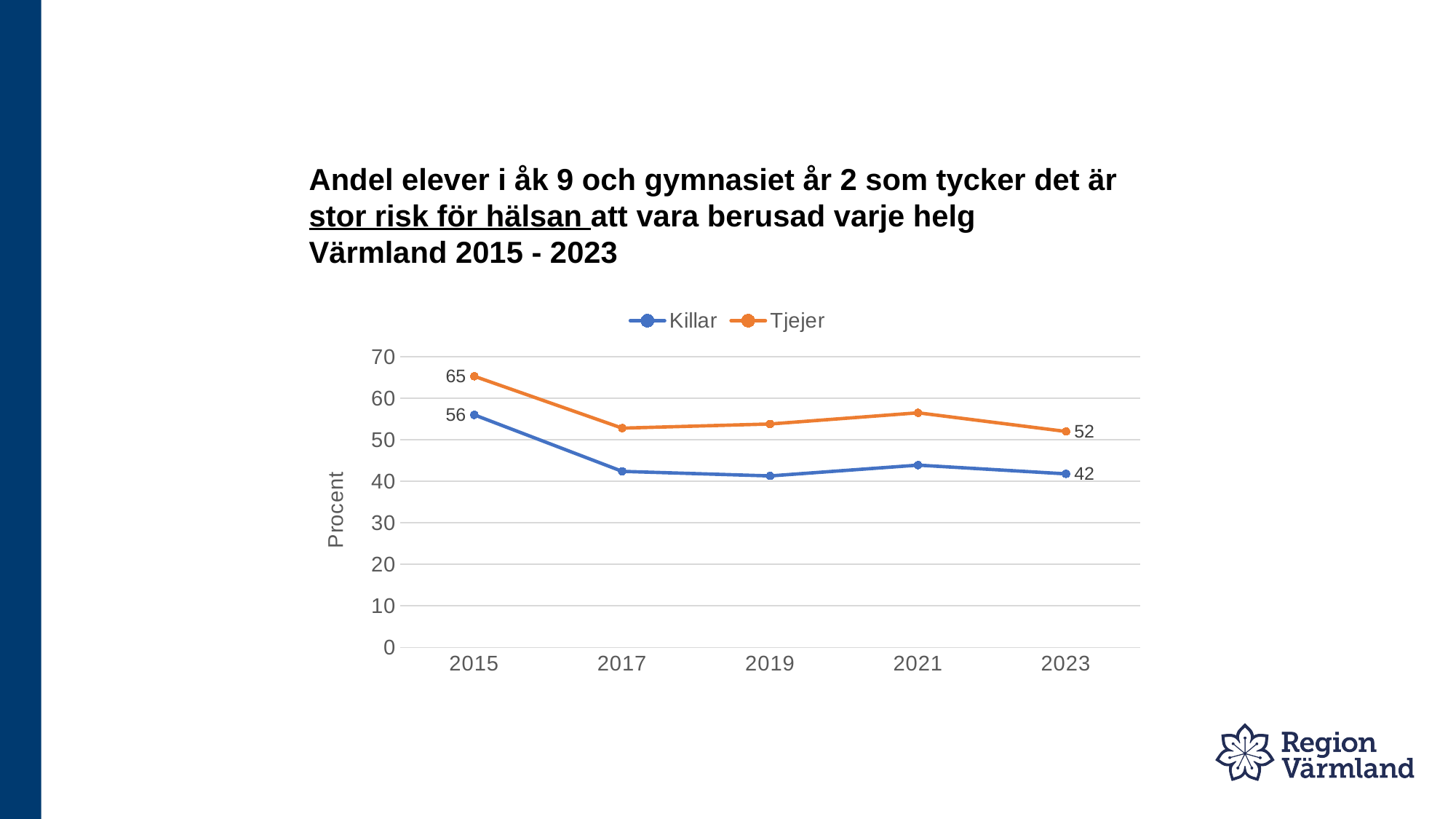
What is the value for Tjejer in 2023? 52 Is the value for Killar in 2019 greater or less than 50? less How much did the value for Killar fall from 2015 to 2023? 14 What is the value for Killar in 2015? 56 Is the value for Tjejer in 2021 greater or less than 50? greater What is the value for Tjejer in 2015? 65 What is the difference between Tjejer and Killar in 2015? 9 What is the value for Killar in 2023? 42 How many years are shown on the x axis? 5 How many series does the legend list? 2 What is the difference between Tjejer and Killar in 2023? 10 Which series is higher in 2021, Killar or Tjejer? Tjejer